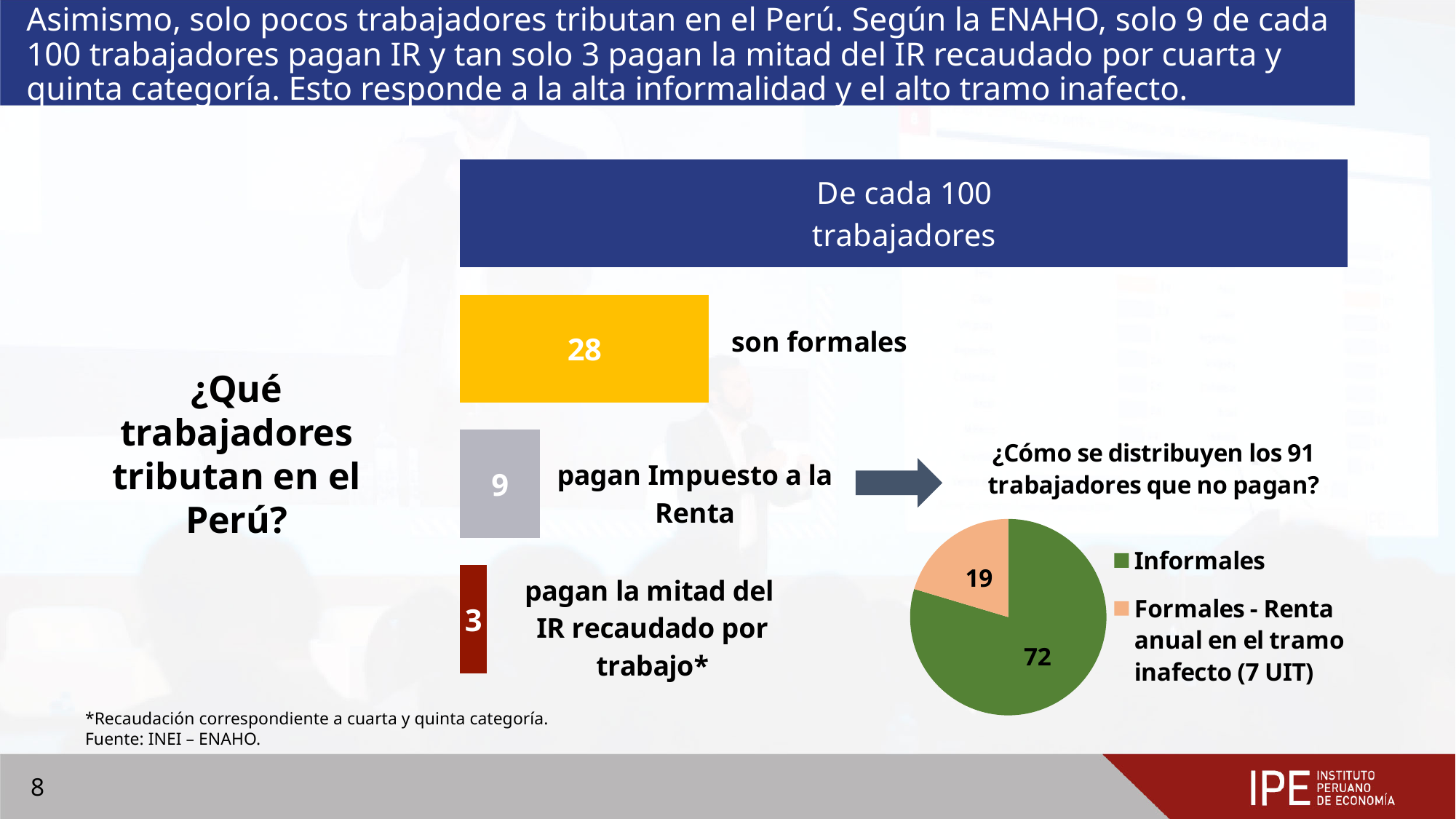
In the bar graphic in the centre of the slide, how many of every 100 workers 'son formales'? 28 How many entries does the legend of the pie chart on the right list? 2 In the pie chart on the right, which slice is the largest? Informales In the pie chart on the right, what is the total of the two slices? 91 How many slices does the pie chart on the right have? 2 In the pie chart '¿Cómo se distribuyen los 91 trabajadores que no pagan?', what is the value for Informales? 72 In the pie chart on the right, what colour is the Informales slice? green In the pie chart on the right, which is larger: Informales or Formales - Renta anual en el tramo inafecto? Informales In the pie chart '¿Cómo se distribuyen los 91 trabajadores que no pagan?', what is the value for 'Formales - Renta anual en el tramo inafecto (7 UIT)'? 19 What kind of chart is shown on the right of the slide under '¿Cómo se distribuyen los 91 trabajadores que no pagan?'? pie chart In the pie chart on the right, which slice is the smallest? Formales - Renta anual en el tramo inafecto (7 UIT) In the pie chart on the right, what is the difference between the Informales slice and the Formales slice? 53